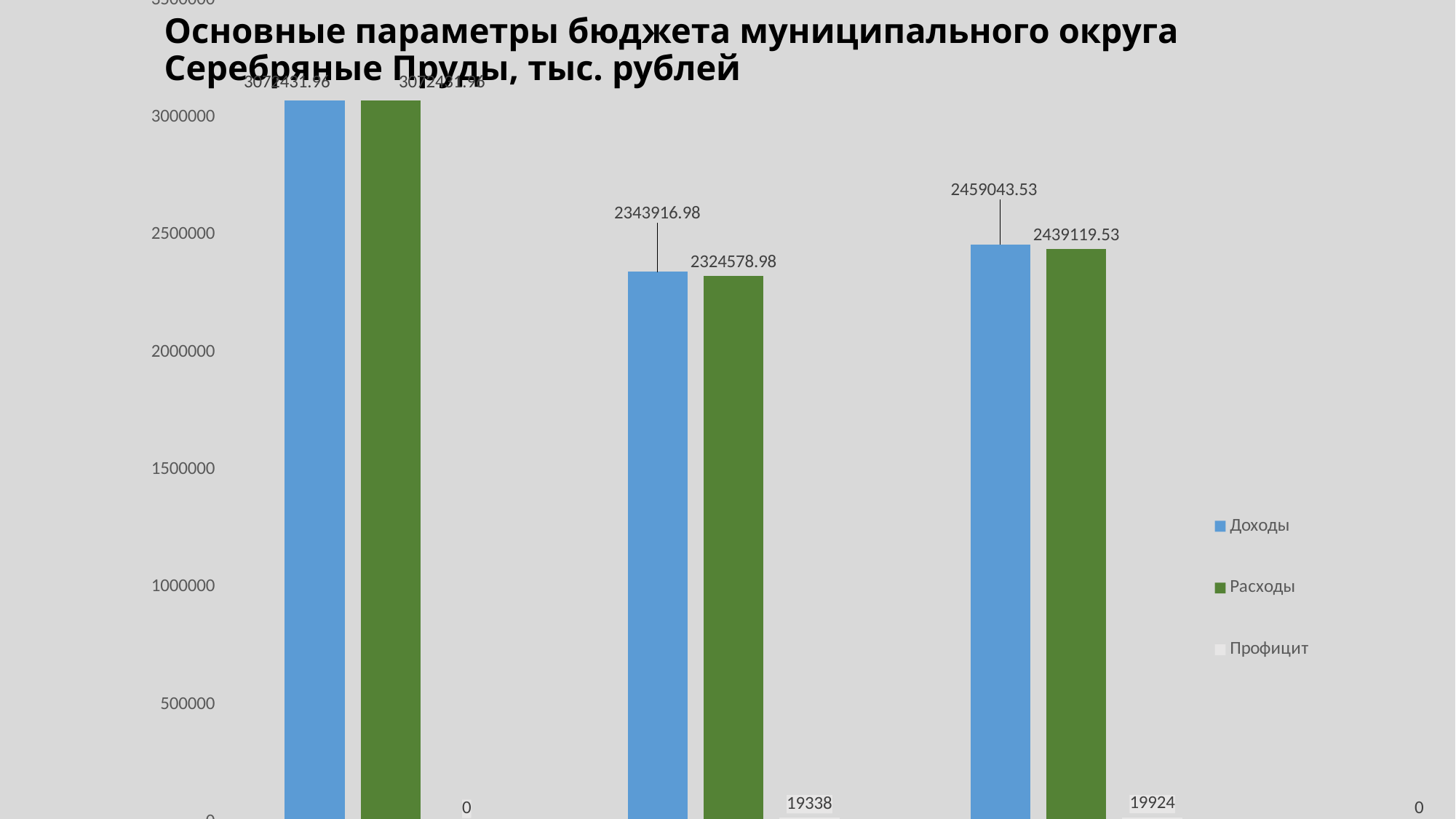
What is the value of Профицит for the rightmost group of bars? 19924 Is the Доходы value for the leftmost group greater or less than 3000000? greater How many series does the legend list? 3 What is the difference between Доходы and Расходы in the middle group of bars? 19338 Which group of bars has the highest Доходы value? the leftmost group What is the value of Доходы for the rightmost group of bars? 2459043.53 What is the value of Расходы for the rightmost group of bars? 2439119.53 What kind of chart is shown on the slide? bar chart What is the value of Расходы for the middle group of bars? 2324578.98 What is the value of Доходы for the middle group of bars? 2343916.98 In the rightmost group, which is larger, Доходы or Расходы? Доходы Which colour represents Расходы in the legend? green